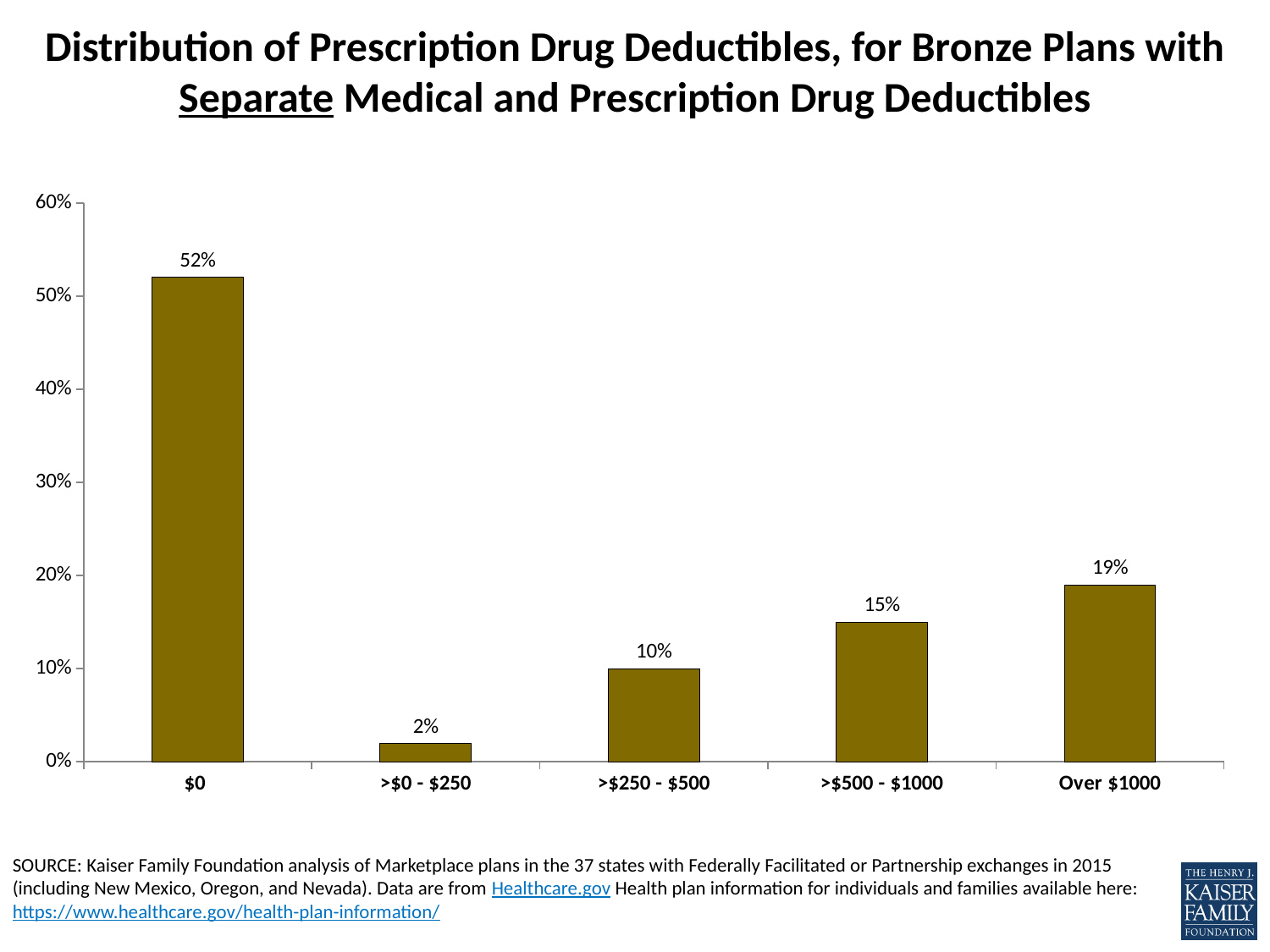
How many deductible categories are shown on the chart? 5 What kind of chart is shown on the slide? Bar chart What is the value for the Over $1000 category? 19% What is the highest value shown on the vertical axis? 60% What is the difference between the $0 category and the Over $1000 category? 33% What is the difference between the >$500 - $1000 category and the >$250 - $500 category? 5% Which deductible category has the highest share of plans? $0 What percentage of bronze plans with separate deductibles have a $0 prescription drug deductible? 52% Which is larger, the value for >$250 - $500 or the value for Over $1000? Over $1000 Which deductible category has the lowest share of plans? >$0 - $250 Is the value for the >$500 - $1000 category greater or less than 20%? less What is the value for the >$500 - $1000 category? 15%